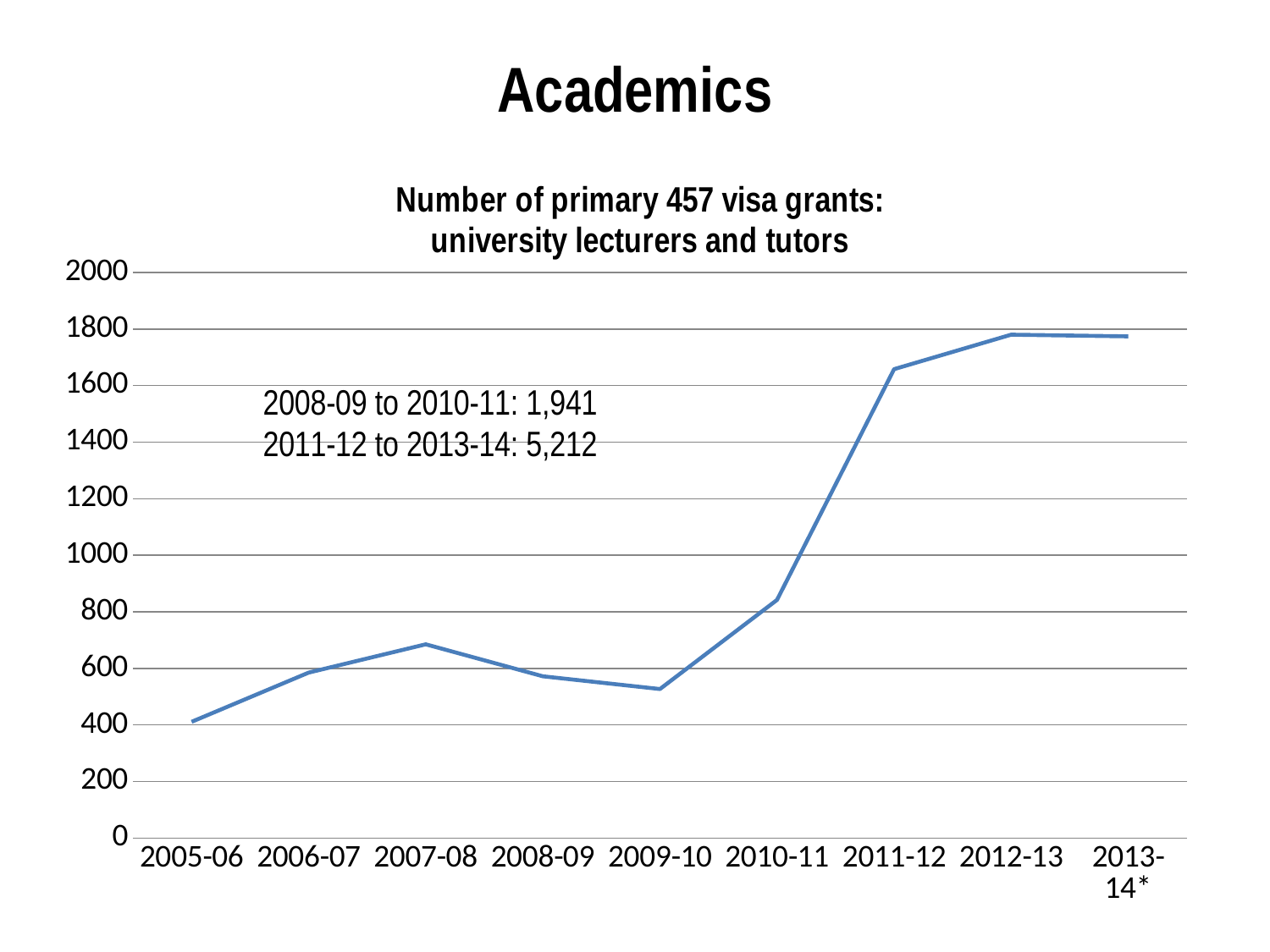
Is the value for 2011-12 greater or less than 1400? greater Which is larger, the value for 2007-08 or the value for 2009-10? 2007-08 What is the title of the chart? Number of primary 457 visa grants: university lecturers and tutors According to the annotation on the chart, what is the total for 2011-12 to 2013-14? 5,212 What kind of chart is shown on the slide? line chart Which year has the lowest number of visa grants? 2005-06 Overall, do the values rise or fall from 2005-06 to 2013-14*? rise Is the value for 2012-13 greater or less than 1600? greater Is the value for 2010-11 greater or less than 1000? less How many years are plotted along the x axis? 9